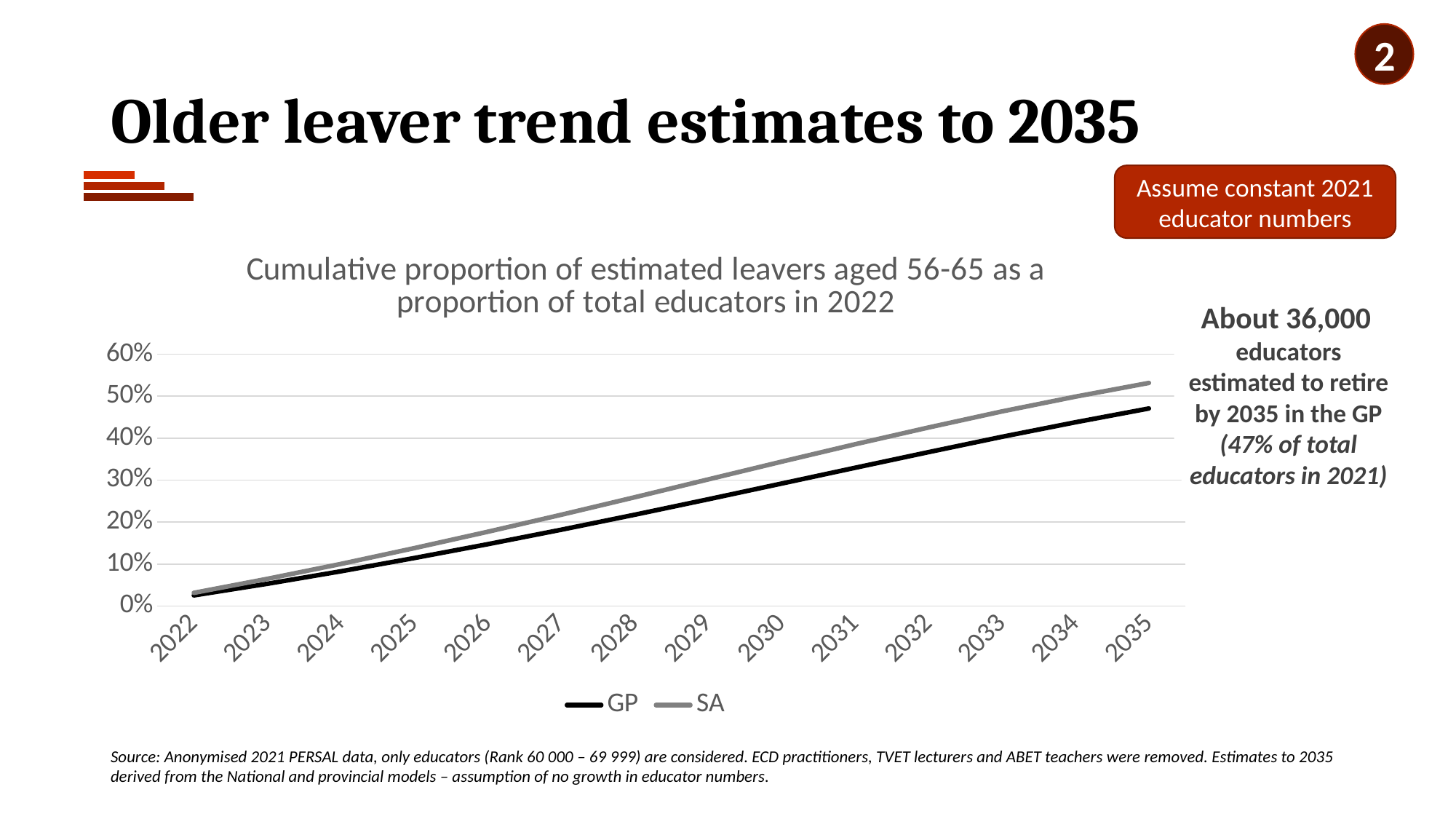
How many series does the chart legend list? 2 What kind of chart is shown on the slide? line chart Is the value for SA in 2035 greater or less than 50%? greater In 2030, which series has the higher value, GP or SA? SA Is the value for GP in 2035 greater or less than 50%? less How many years are shown along the x axis of the chart? 14 Which series is drawn with the black line in the chart? GP Do the values for SA rise or fall from 2022 to 2035? rise Do the values for GP rise or fall from 2022 to 2035? rise Is the value for SA in 2030 greater or less than 30%? greater In 2035, which series has the higher value, GP or SA? SA